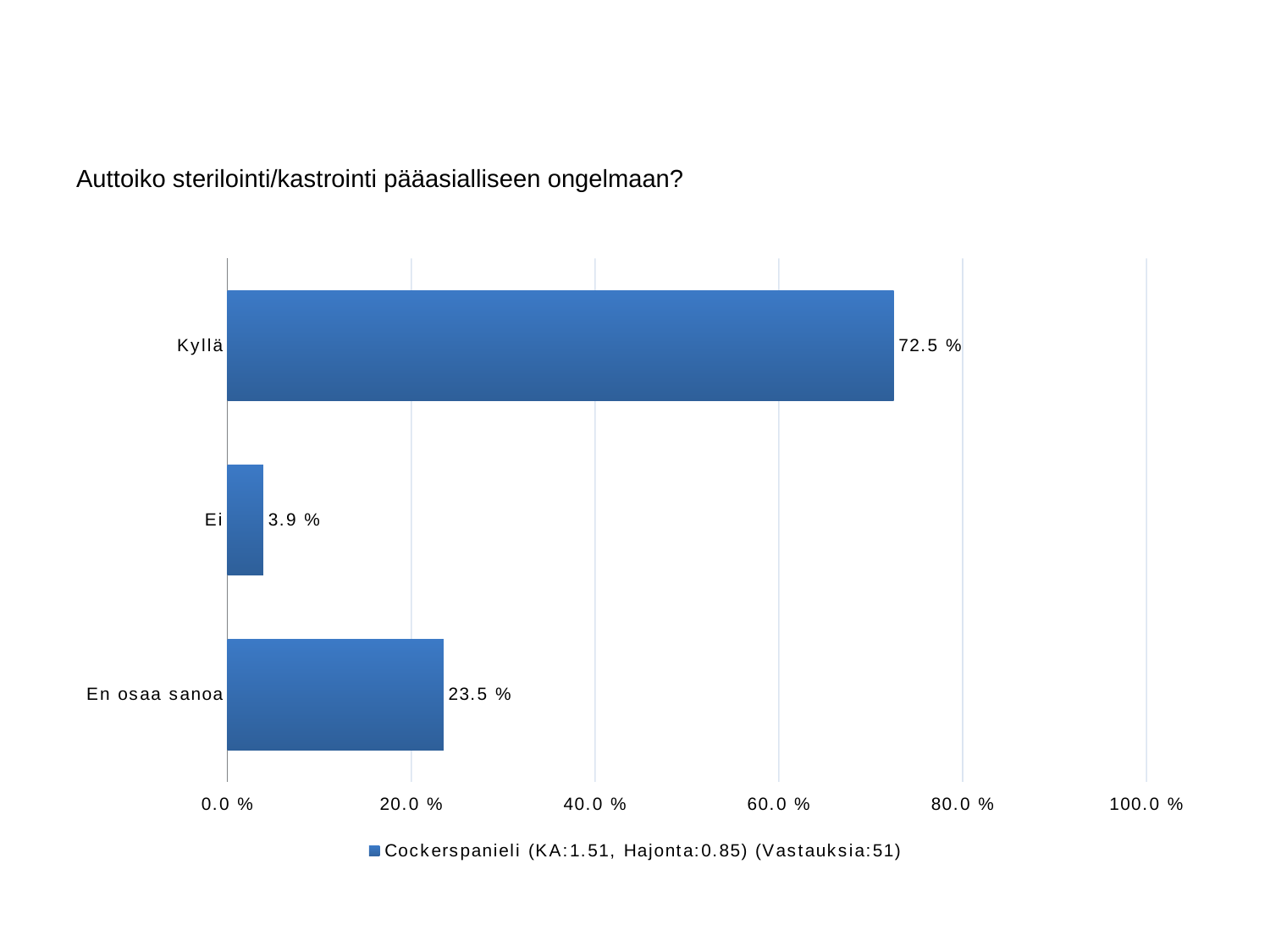
Which category has the lowest value? Ei Which is larger, the value for Ei or the value for En osaa sanoa? En osaa sanoa What is the difference between the values for En osaa sanoa and Ei? 19.6 % What is the value for Ei? 3.9 % Is the value for Kyllä greater or less than 60.0 %? greater What is the title of the chart? Auttoiko sterilointi/kastrointi pääasialliseen ongelmaan? What is the value for En osaa sanoa? 23.5 % Which category has the highest value? Kyllä How many categories are shown in the chart? 3 What is the difference between the values for Kyllä and En osaa sanoa? 49.0 % What is the value for Kyllä? 72.5 % What kind of chart is shown on the slide? bar chart